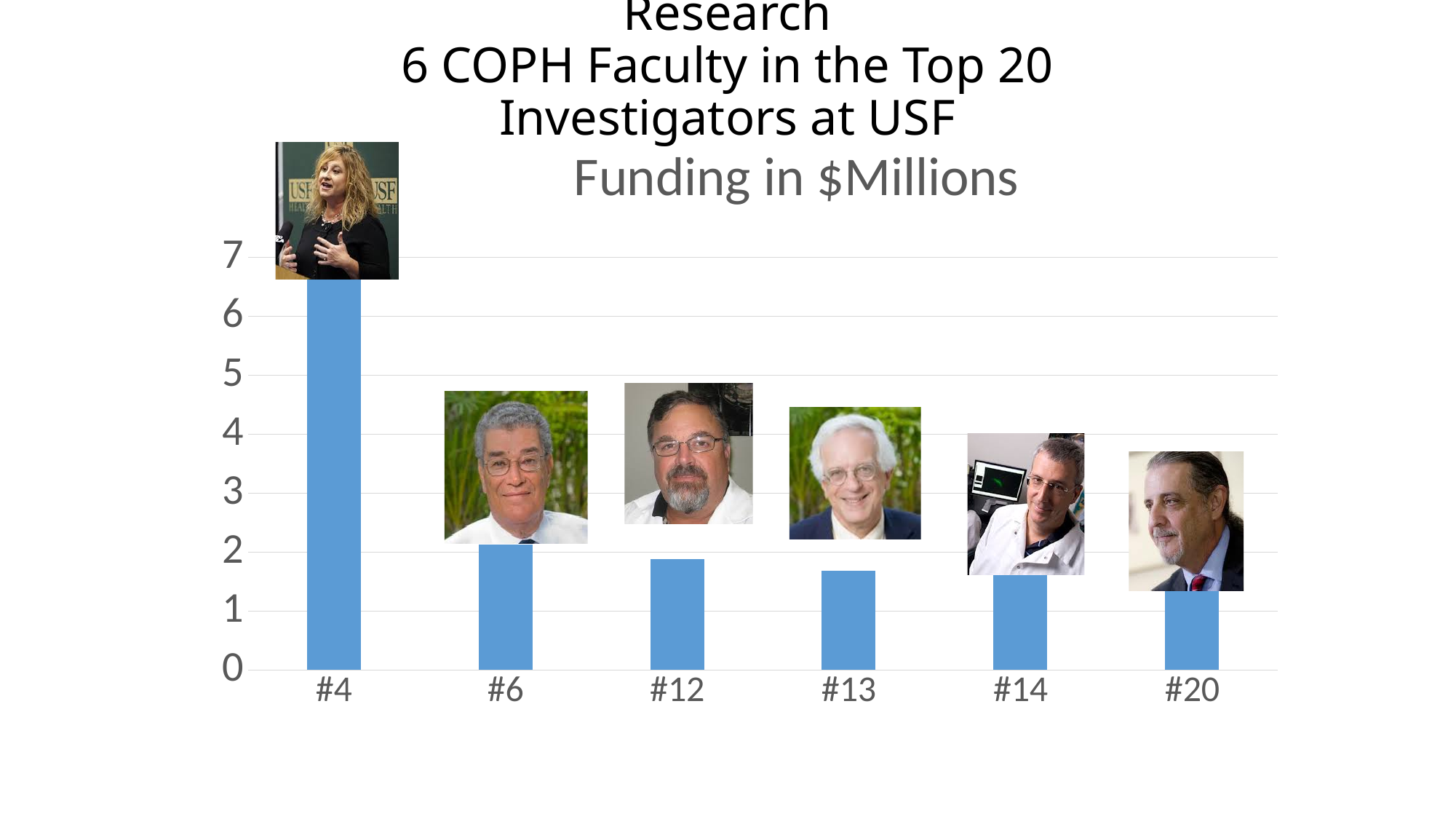
Is the value for #13 greater or less than 2? less How many categories (investigator ranks) are plotted on the chart? 6 Is the value for #20 greater or less than 1? greater Which has the larger value, #6 or #20? #6 Is the value for #4 greater or less than 5? greater Which has the larger value, #4 or #6? #4 What is the title of the chart? Funding in $Millions Which category has the lowest bar? #20 Do the bar values rise or fall moving from #4 to #20 along the x axis? fall Which category has the highest bar? #4 What kind of chart is shown on the slide? bar chart